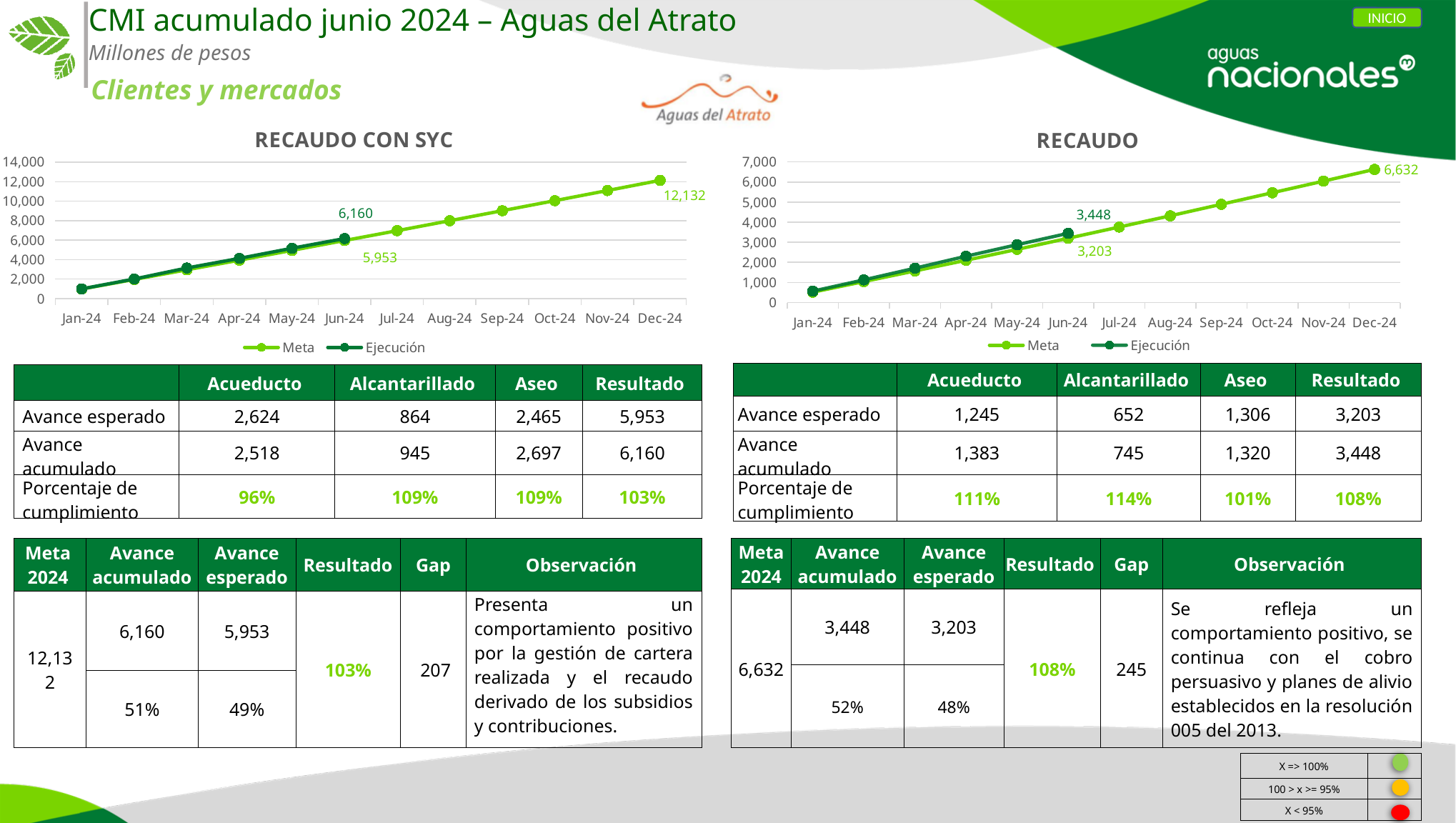
In the RECAUDO chart, what is the Meta value labelled at Dec-24? 6,632 In the RECAUDO chart, does the Meta series rise or fall from Jan-24 to Dec-24? Rise In the RECAUDO CON SYC chart, what is the Meta value labelled at Dec-24? 12,132 In the RECAUDO CON SYC chart, what is the Meta value labelled at Jun-24? 5,953 How many series does the legend of the RECAUDO CON SYC chart list? 2 In the RECAUDO chart, which series has the larger value at Jun-24, Meta or Ejecución? Ejecución In the RECAUDO CON SYC chart, what is the Ejecución value labelled at Jun-24? 6,160 In the RECAUDO chart, what is the difference between the Ejecución and Meta values labelled at Jun-24? 245 In the RECAUDO CON SYC chart, what is the difference between the Ejecución and Meta values labelled at Jun-24? 207 What kind of chart is the RECAUDO CON SYC chart? Line chart How many months are shown on the x axis of the RECAUDO chart? 12 In the RECAUDO chart, what is the Ejecución value labelled at Jun-24? 3,448